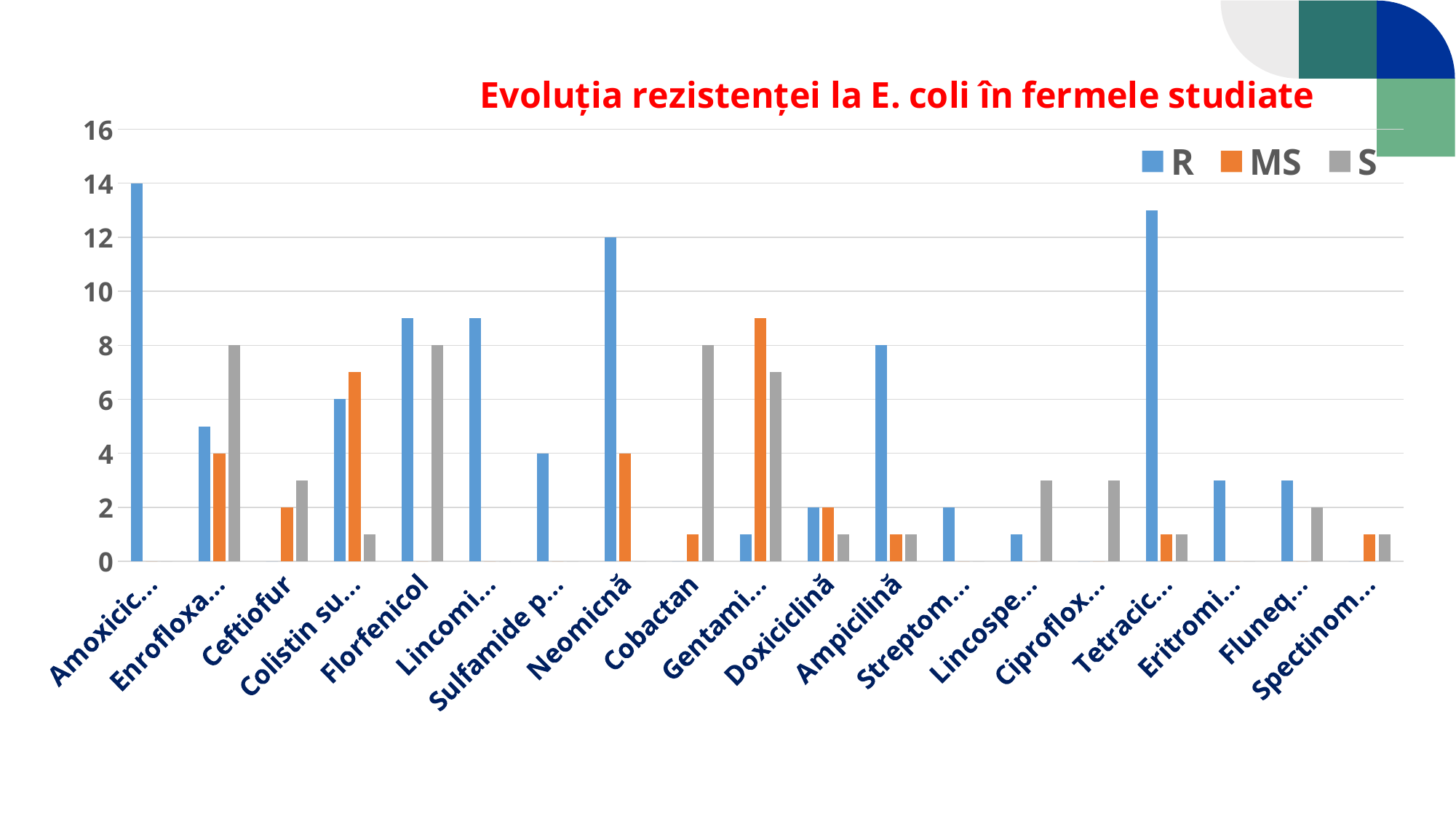
What is the MS value for Neomicnă? 4 What are the series names in the legend? R, MS, S How many categories are shown on the x axis? 19 What type of chart is shown on the slide? bar chart Which series has the highest value for Cobactan? S How many series does the legend list? 3 Is the R value for Neomicnă greater or less than 10? greater What is the S value for Cobactan? 8 Is the R value for Ampicilină greater or less than the MS value for Ampicilină? greater